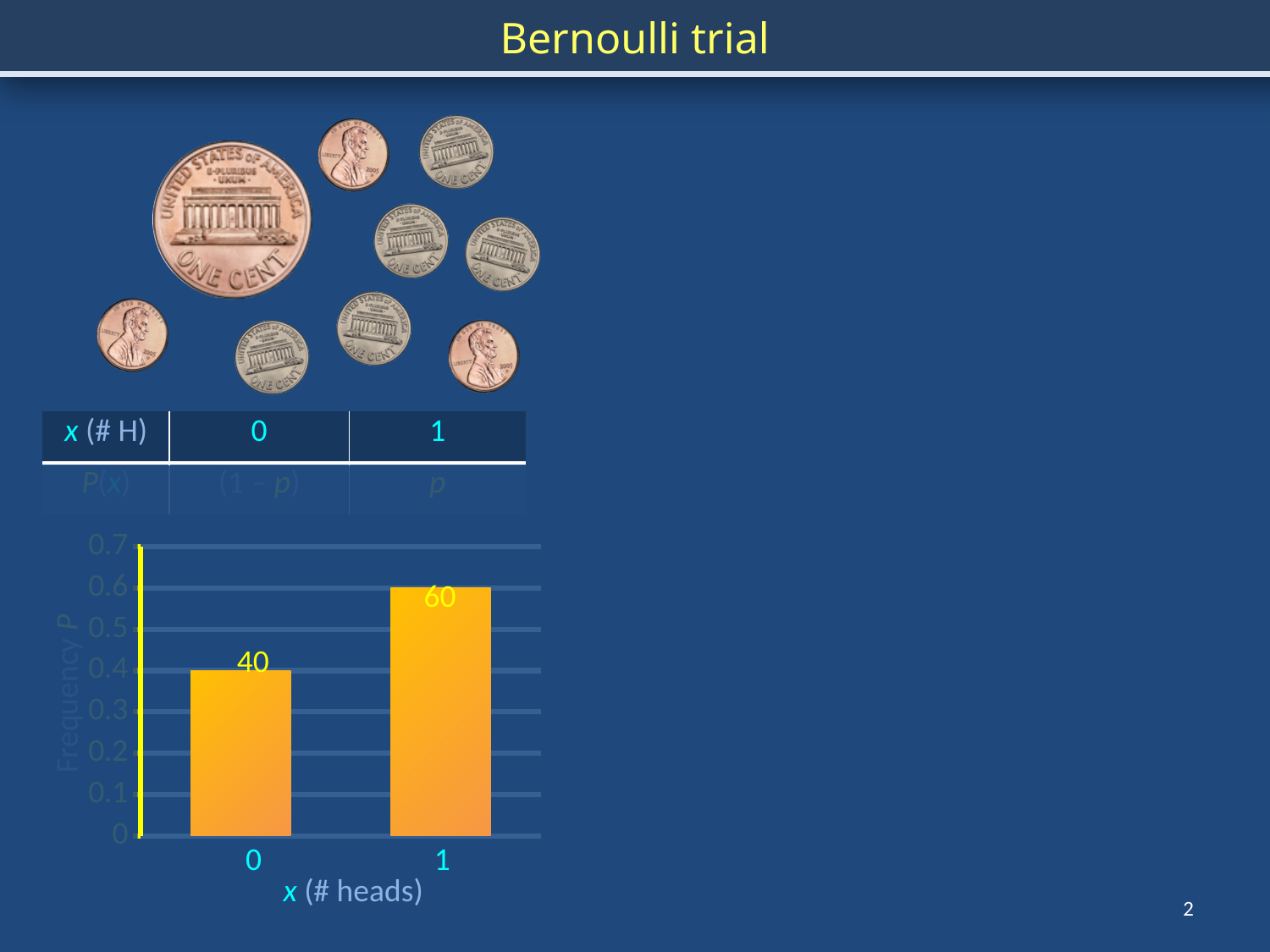
How many bars are plotted in the chart? 2 Which value of x has the shorter bar? 0 What is the data label on the bar for x = 1? 60 What is the difference between the data labels for x = 1 and x = 0? 20 Is the bar for x = 0 above or below the 0.5 gridline on the y axis? below What kind of chart is shown on the slide? bar chart Which value of x has the taller bar? 1 What is the highest tick value shown on the y axis? 0.7 Is the bar for x = 1 above or below the 0.5 gridline on the y axis? above Is the bar for x = 1 larger or smaller than the bar for x = 0? larger What is the data label on the bar for x = 0? 40 What is the label of the x axis of the chart? x (# heads)